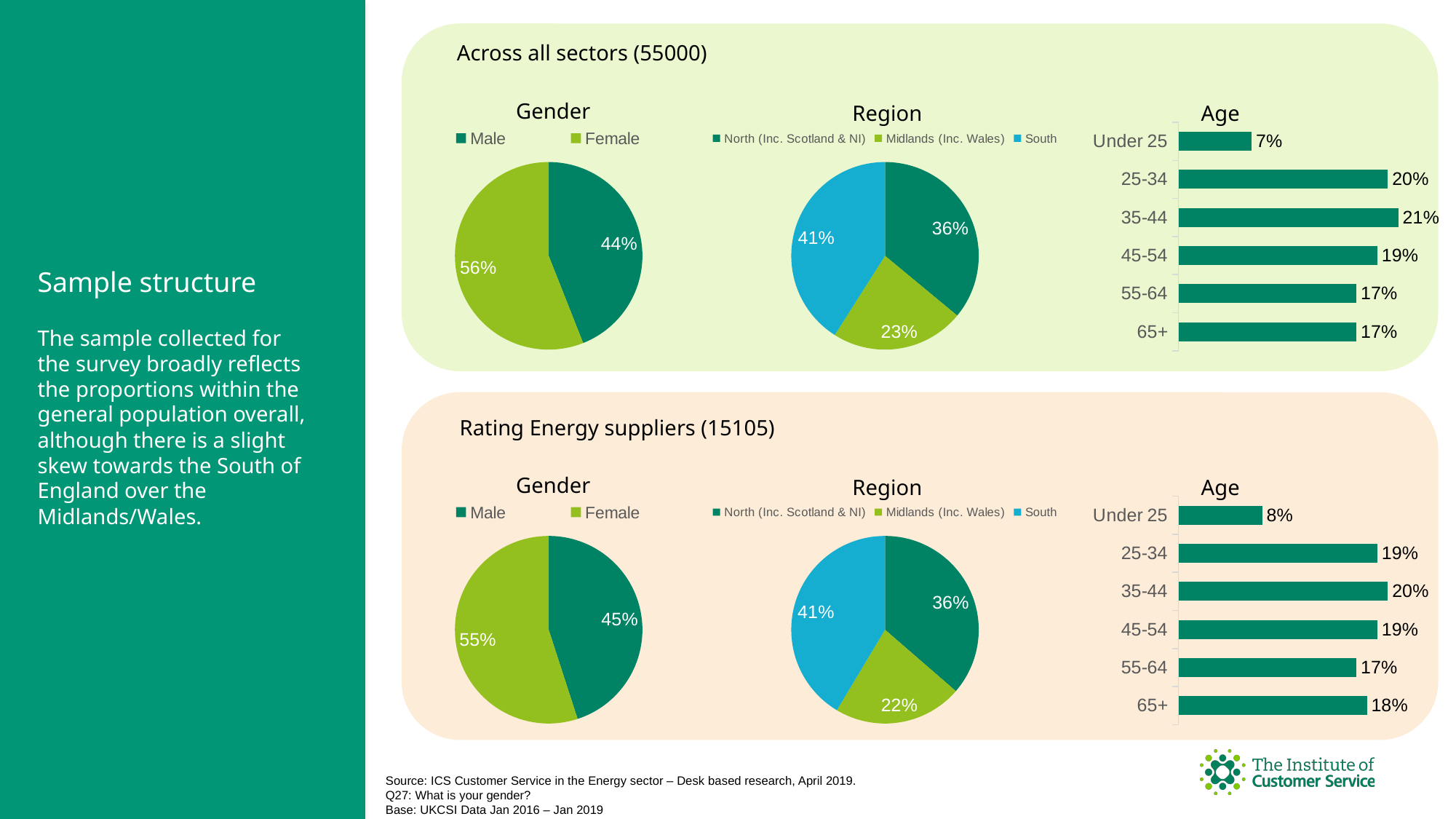
In the 'Across all sectors' Region pie chart, what is the value for South? 41% In the 'Across all sectors' Age bar chart, what is the difference between the 25-34 and Under 25 values? 13% In the 'Rating Energy suppliers' Age bar chart, which is larger: 65+ or 55-64? 65+ How many entries does the legend of the 'Across all sectors' Region pie chart list? 3 In the 'Rating Energy suppliers' Region pie chart, what is the value for North (Inc. Scotland & NI)? 36% In the 'Rating Energy suppliers' Region pie chart, what is the value for Midlands (Inc. Wales)? 22% In the 'Across all sectors' Age bar chart, which age group has the highest value? 35-44 How many age groups are shown in the 'Rating Energy suppliers' Age bar chart? 6 In the 'Rating Energy suppliers' Age bar chart, which age group has the lowest value? Under 25 In the 'Across all sectors' Gender pie chart, what share is Female? 56% In the 'Rating Energy suppliers' Gender pie chart, what share is Male? 45% What type of chart is the Age chart in the 'Across all sectors' section? Bar chart